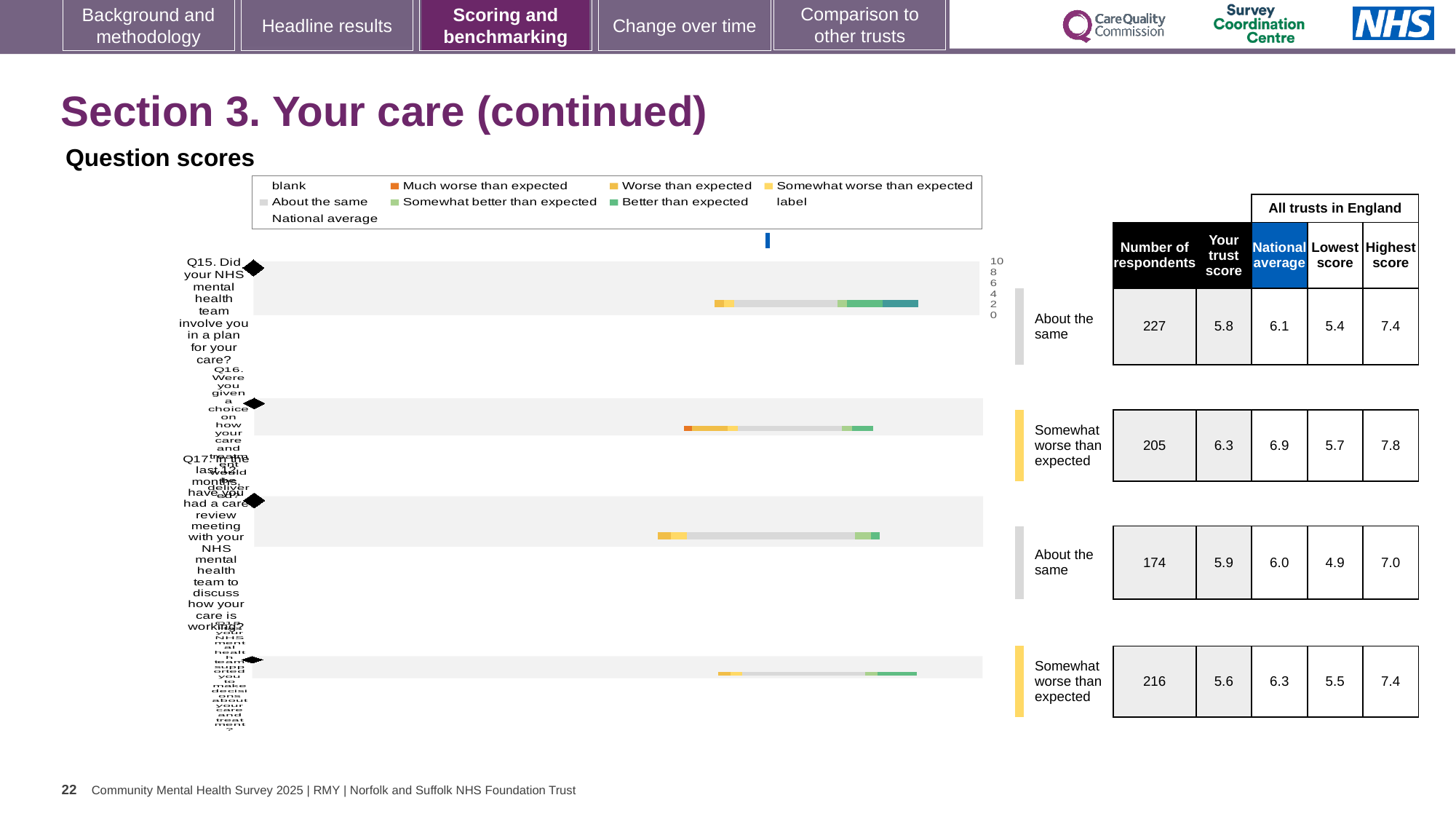
What is the highest score among all trusts in England for Q17 (care review meeting in the last 12 months)? 7.0 For Q15, what is the difference between the highest score (7.4) and the lowest score (5.4) among all trusts in England? 2.0 What is the trust's score for Q17 (care review meeting in the last 12 months)? 5.9 For Q15, which is larger: the trust's score or the national average? National average Which question has the highest number of respondents in the table? Q15 What is the national average score for Q15 (involving you in a plan for your care)? 6.1 Which question has the lowest number of respondents in the table? Q17 In the table beside the chart, what is the number of respondents for Q15 (Did your NHS mental health team involve you in a plan for your care?)? 227 What benchmark category is shown for Q17 (care review meeting in the last 12 months)? About the same How many questions (bars) are plotted in the question scores chart? 4 What kind of chart is used to show the question scores on this slide? bar chart What is the trust's score for Q15 (involving you in a plan for your care)? 5.8